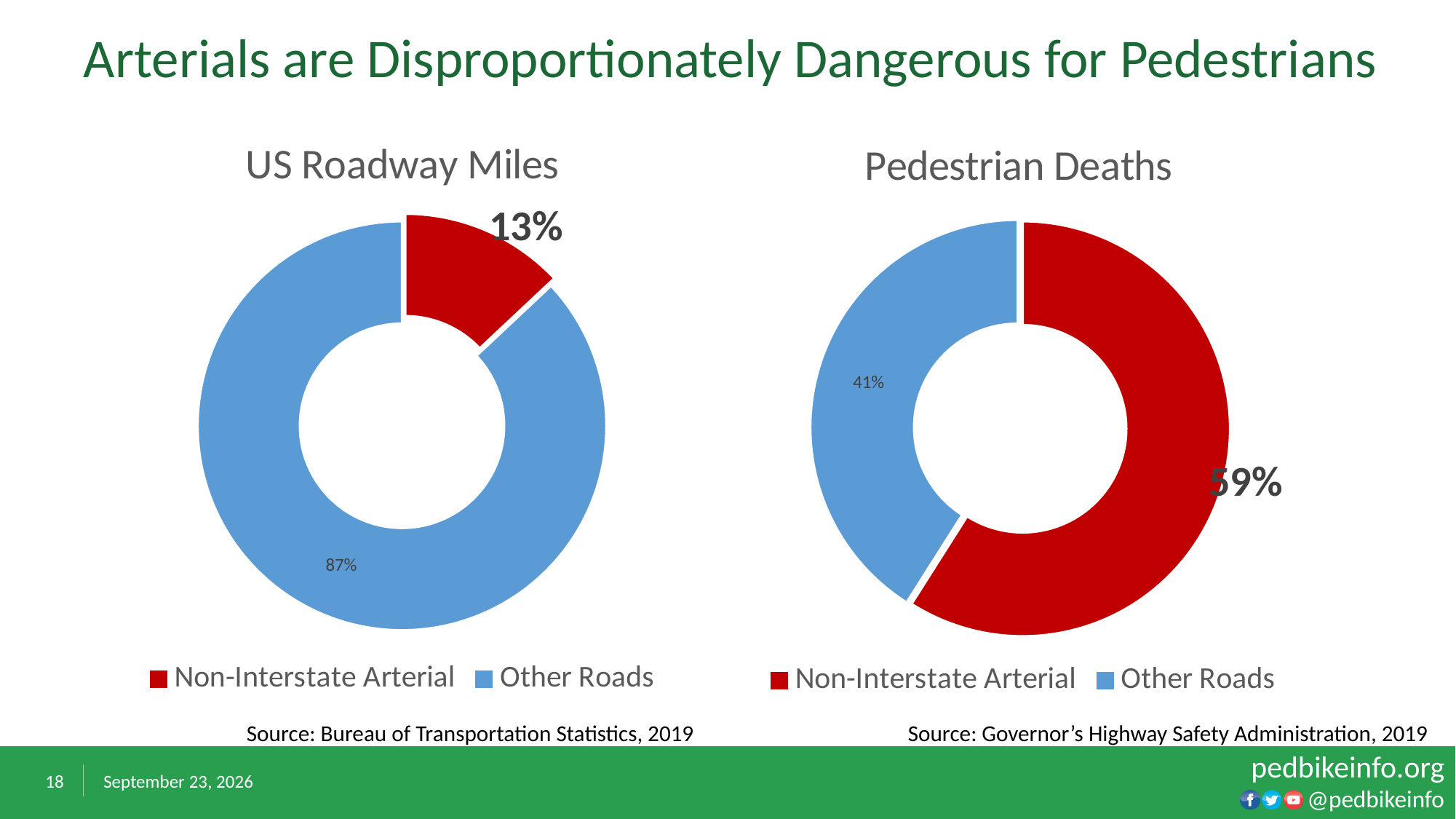
In the Pedestrian Deaths chart, which category has the smallest share? Other Roads In the Pedestrian Deaths chart, which is larger: Non-Interstate Arterial or Other Roads? Non-Interstate Arterial In the Pedestrian Deaths chart, what share of pedestrian deaths occurs on Other Roads? 41% In the US Roadway Miles chart, which category has the largest share? Other Roads In the US Roadway Miles chart, what share of roadway miles is Other Roads? 87% In the US Roadway Miles chart, what share of roadway miles is Non-Interstate Arterial? 13% In the US Roadway Miles chart, what is the difference between the Other Roads share and the Non-Interstate Arterial share? 74 percentage points What is the difference between the Non-Interstate Arterial share in the Pedestrian Deaths chart and the Non-Interstate Arterial share in the US Roadway Miles chart? 46 percentage points In the Pedestrian Deaths chart, what share of pedestrian deaths occurs on Non-Interstate Arterial roads? 59% How many categories does the legend of the US Roadway Miles chart list? 2 In the Pedestrian Deaths chart, what colour represents Non-Interstate Arterial? Red What kind of chart is the Pedestrian Deaths chart? Doughnut (pie) chart